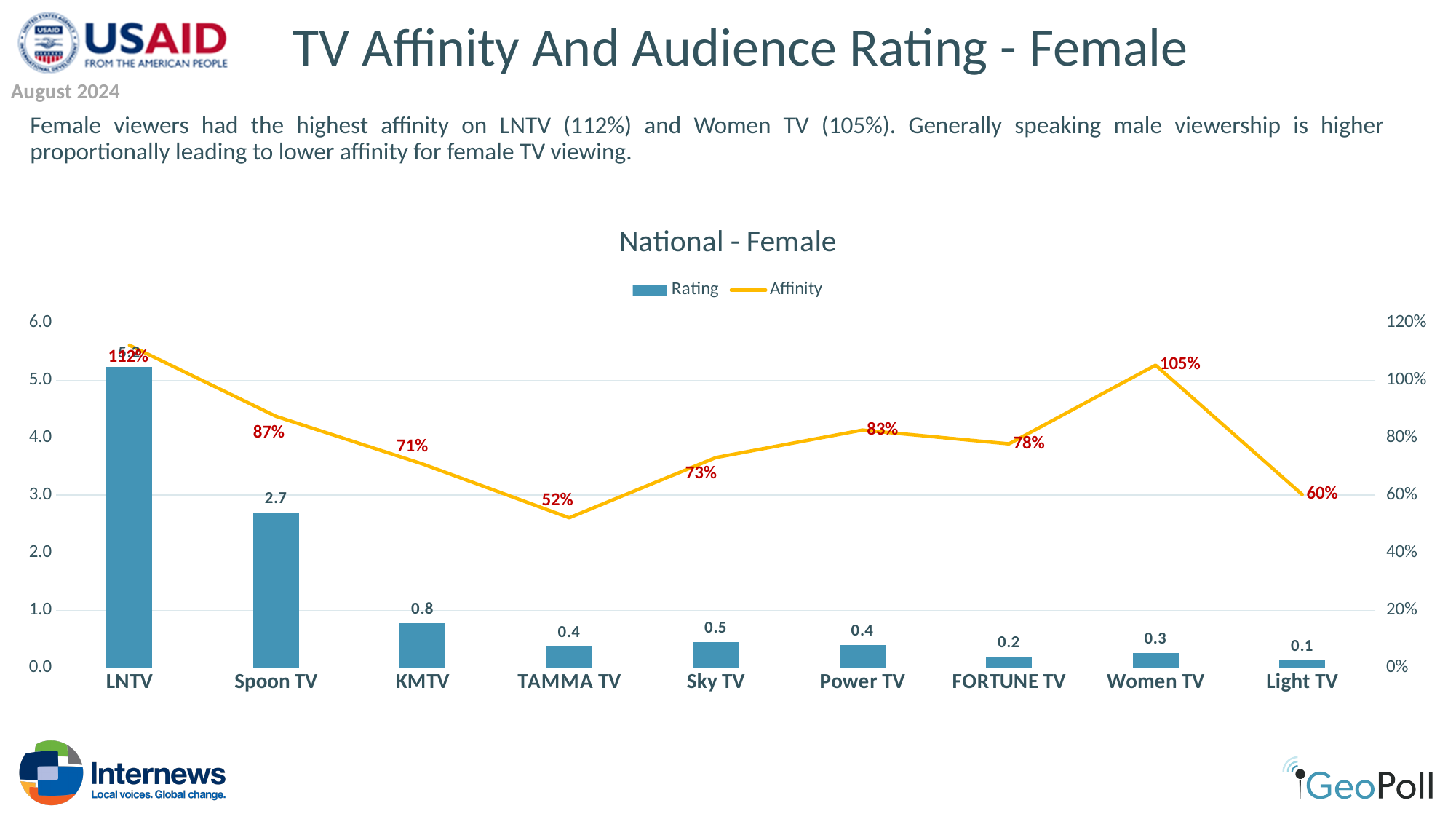
How many series does the legend list? 2 Which channel has the lowest Affinity? TAMMA TV What is the Affinity value for TAMMA TV? 52% Which channel has the lowest Rating? Light TV What is the title of the chart? National - Female What is the Rating value for KMTV? 0.8 Which channel has the highest Affinity? LNTV How many channels are shown on the x axis? 9 What is the Rating value for Spoon TV? 2.7 What is the difference in Affinity between Power TV and FORTUNE TV? 5% What is the Affinity value for Women TV? 105% Which has a higher Affinity, Sky TV or KMTV? Sky TV